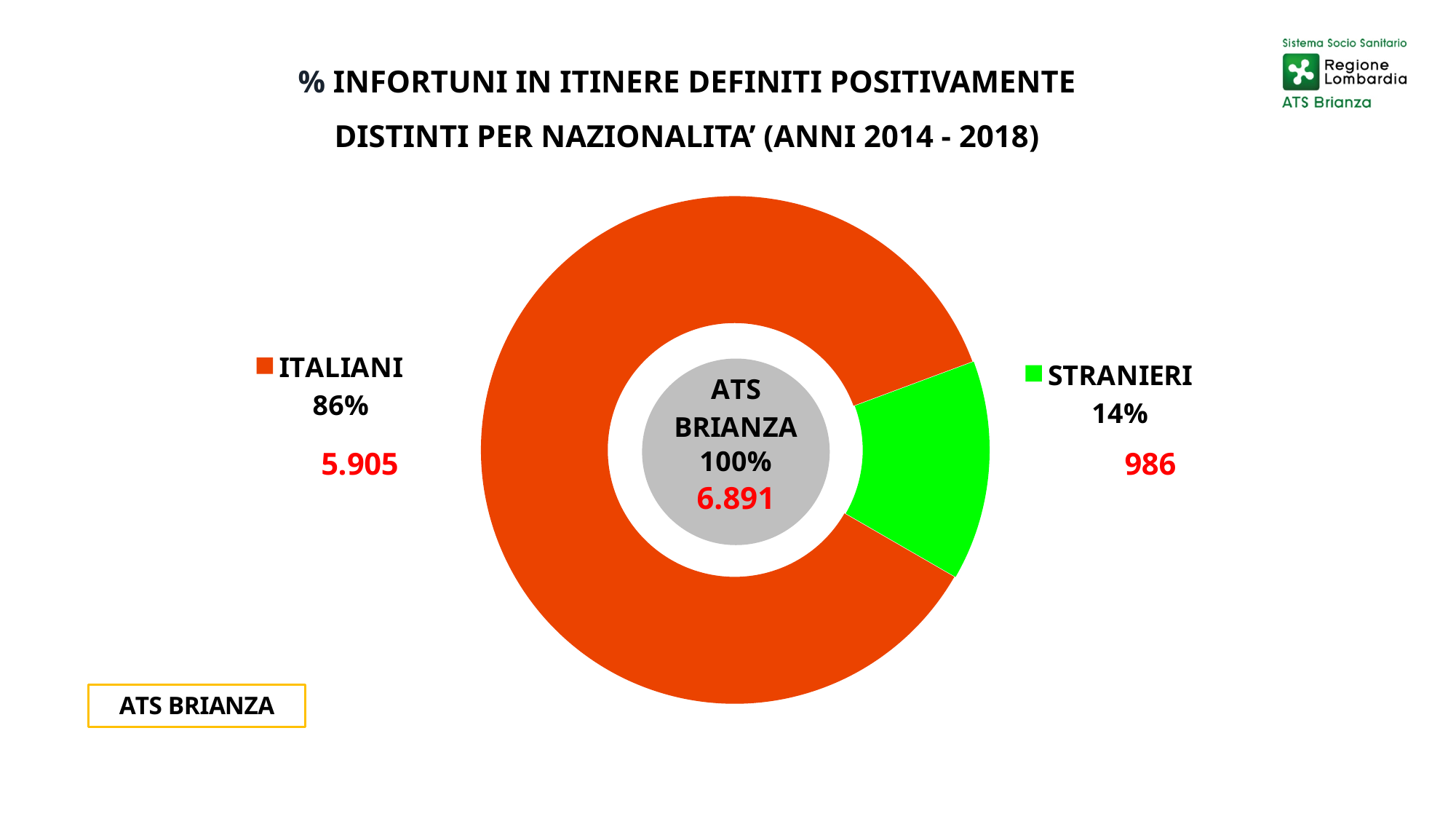
What percentage share does ITALIANI have in the chart? 86% What total is shown in the centre of the chart for ATS BRIANZA? 6.891 How many categories are shown in the chart? 2 What colour represents STRANIERI in the chart? Green What is the difference in percentage points between the ITALIANI and STRANIERI shares? 72 Which is larger, the value for ITALIANI or the value for STRANIERI? ITALIANI Which category has the largest share of the chart? ITALIANI What kind of chart is shown on the slide? Pie chart (doughnut) What percentage share does STRANIERI have in the chart? 14% What is the number shown for STRANIERI? 986 Which category has the smallest share of the chart? STRANIERI What is the number shown for ITALIANI? 5.905